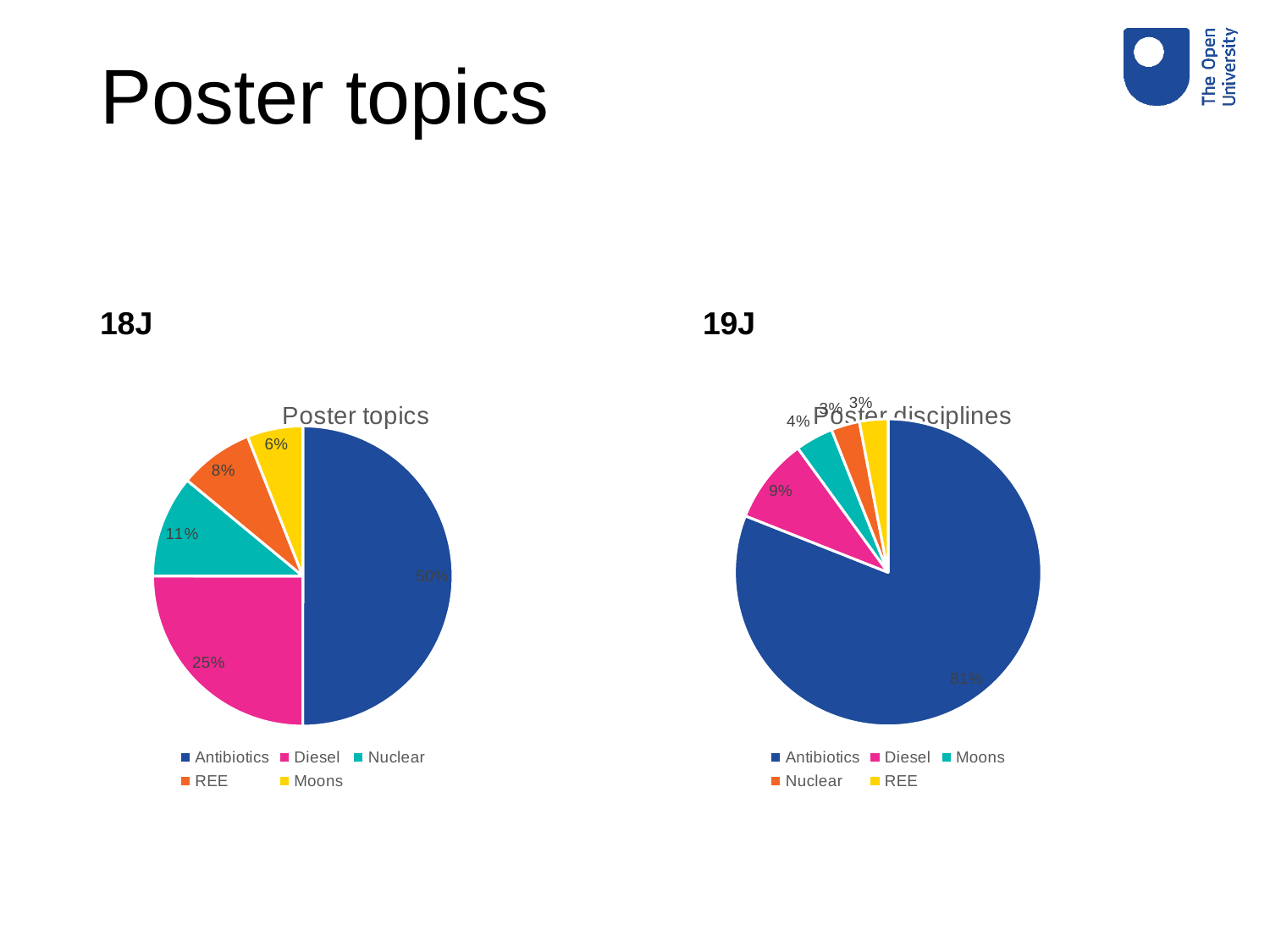
In the 'Poster topics' pie chart (18J), what share does Antibiotics have? 50% In the 'Poster topics' pie chart (18J), how many categories does the legend list? 5 In the 'Poster disciplines' pie chart (19J), what share does Diesel have? 9% In the 'Poster disciplines' pie chart (19J), which is larger, the Diesel slice or the Moons slice? Diesel In the 'Poster disciplines' pie chart (19J), which category has the largest slice? Antibiotics What kind of chart is used for the 18J 'Poster topics' data? Pie chart In the 'Poster topics' pie chart (18J), what share does Nuclear have? 11% In the 'Poster disciplines' pie chart (19J), what share does Antibiotics have? 81% In the 'Poster topics' pie chart (18J), what share does Diesel have? 25% In the 'Poster topics' pie chart (18J), what is the difference between the Diesel and REE shares? 17% What is the title of the pie chart on the right (19J)? Poster disciplines In the 'Poster topics' pie chart (18J), which category has the smallest slice? Moons